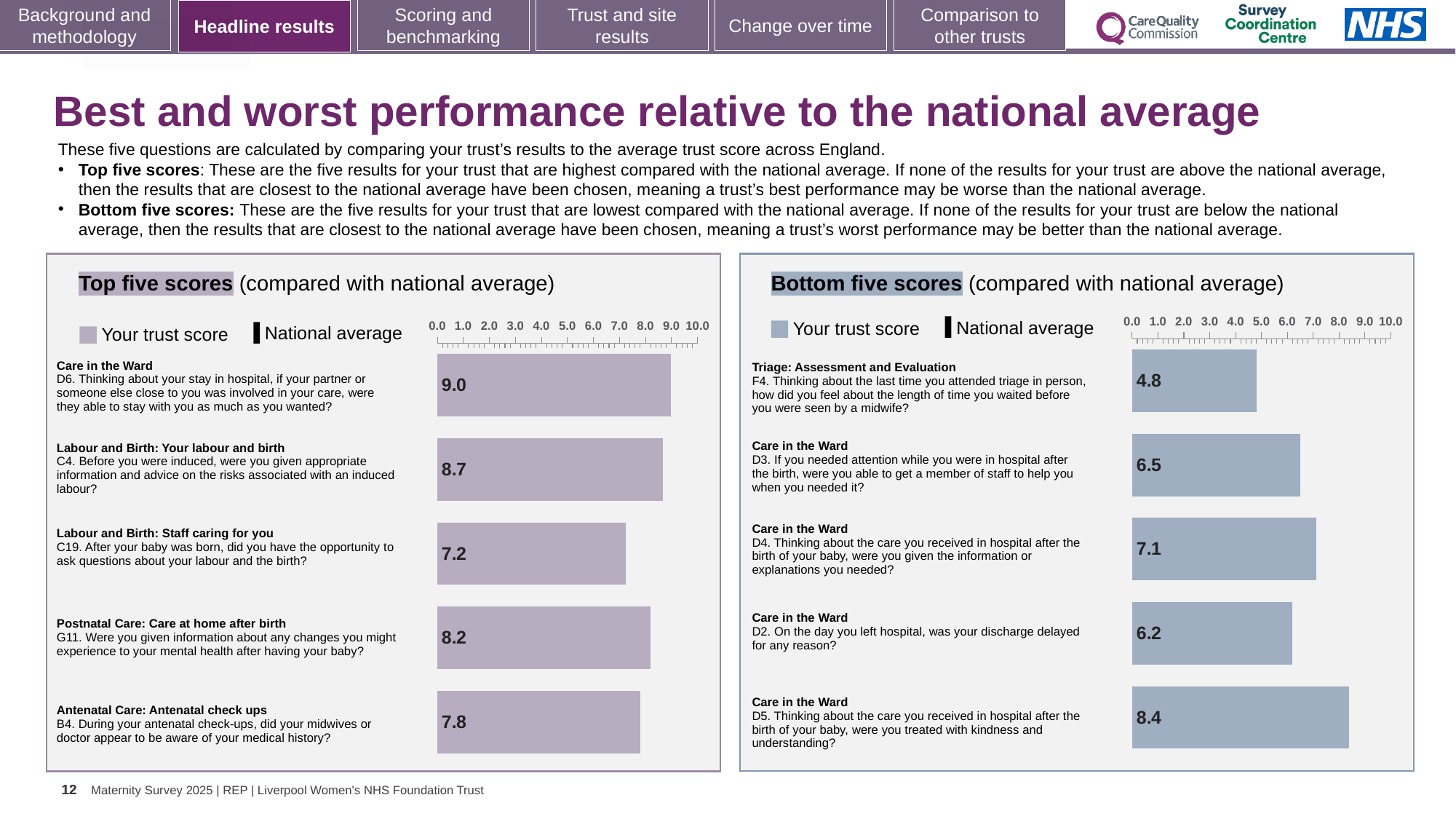
In the Bottom five scores chart, what is the difference between the trust scores for D5 and F4? 3.6 In the Top five scores chart, what is the trust score for D6 (Care in the Ward: were your partner or someone close able to stay with you as much as you wanted)? 9.0 What type of chart is used in the Top five scores panel? Bar chart In the Bottom five scores chart, which question has the highest trust score? D5 (Care in the Ward), 8.4 In the Top five scores chart, which question has the highest trust score? D6 (Care in the Ward), 9.0 In the Top five scores chart, which has the larger trust score: C4 (induced labour information) or G11 (mental health changes information)? C4, 8.7 In the Bottom five scores chart, which question has the lowest trust score? F4 (Triage: Assessment and Evaluation), 4.8 How many entries does the legend of the Bottom five scores chart list? 2 How many bars are plotted in the Bottom five scores chart? 5 In the Top five scores chart, what is the difference between the trust scores for D6 and C19? 1.8 In the Bottom five scores chart, what is the trust score for F4 (Triage: length of time you waited before being seen by a midwife)? 4.8 In the Top five scores chart, which question has the lowest trust score? C19 (Labour and Birth: Staff caring for you), 7.2